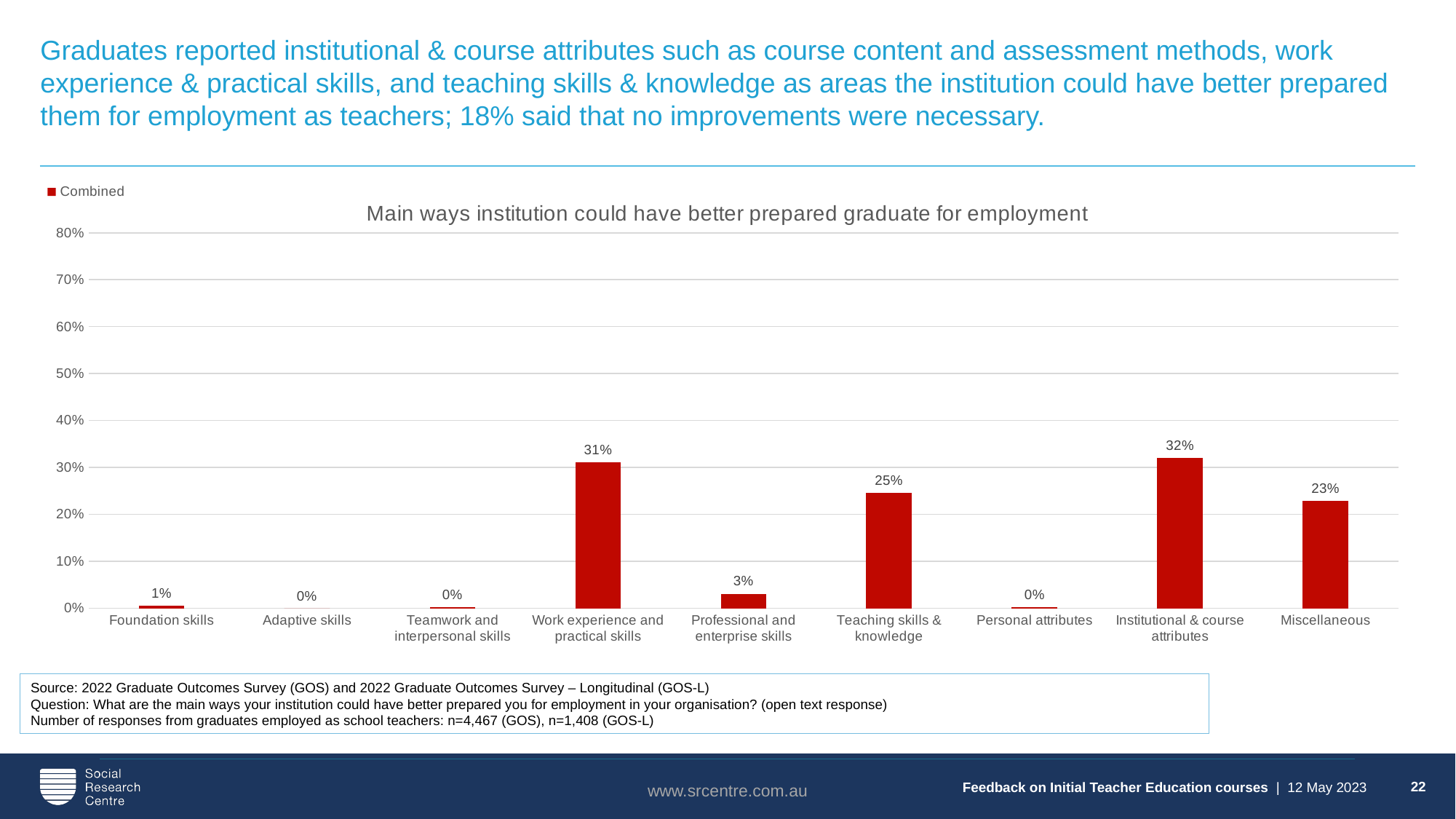
Which is larger, Teaching skills & knowledge or Miscellaneous? Teaching skills & knowledge Which category has the highest value? Institutional & course attributes What is the title of the chart? Main ways institution could have better prepared graduate for employment What is the value for Professional and enterprise skills? 3% What is the value for Work experience and practical skills? 31% How many categories are shown on the x axis? 9 Is the value for Work experience and practical skills greater or less than 20%? greater What is the value for Institutional & course attributes? 32% What kind of chart is shown? bar chart How many series does the legend list? 1 What is the difference between Institutional & course attributes and Miscellaneous? 9% What is the value for Teaching skills & knowledge? 25%